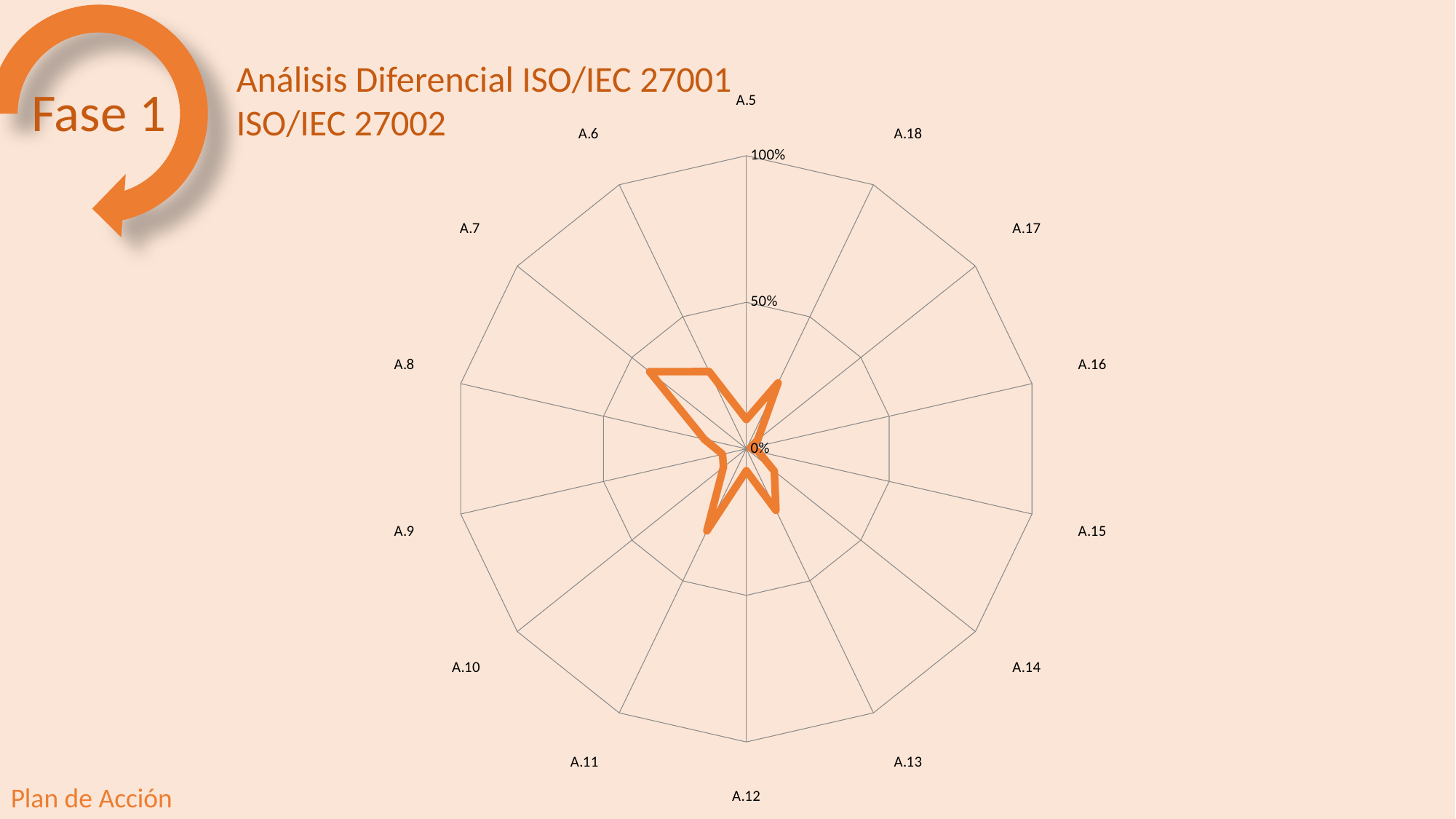
Is the value for A.11 greater or less than 50%? less Which category has the highest value on the radar chart? A.7 Is the value for A.7 greater or less than 50%? less How many categories (axes) does the radar chart have? 14 What is the title of the chart on the slide? Análisis Diferencial ISO/IEC 27001 ISO/IEC 27002 What kind of chart is shown on the slide? Radar chart Is the value for A.18 greater or less than 50%? less What is the maximum value shown on the radar chart's axis scale? 100% Which has the larger value, A.11 or A.16? A.11 Which has the larger value, A.7 or A.12? A.7